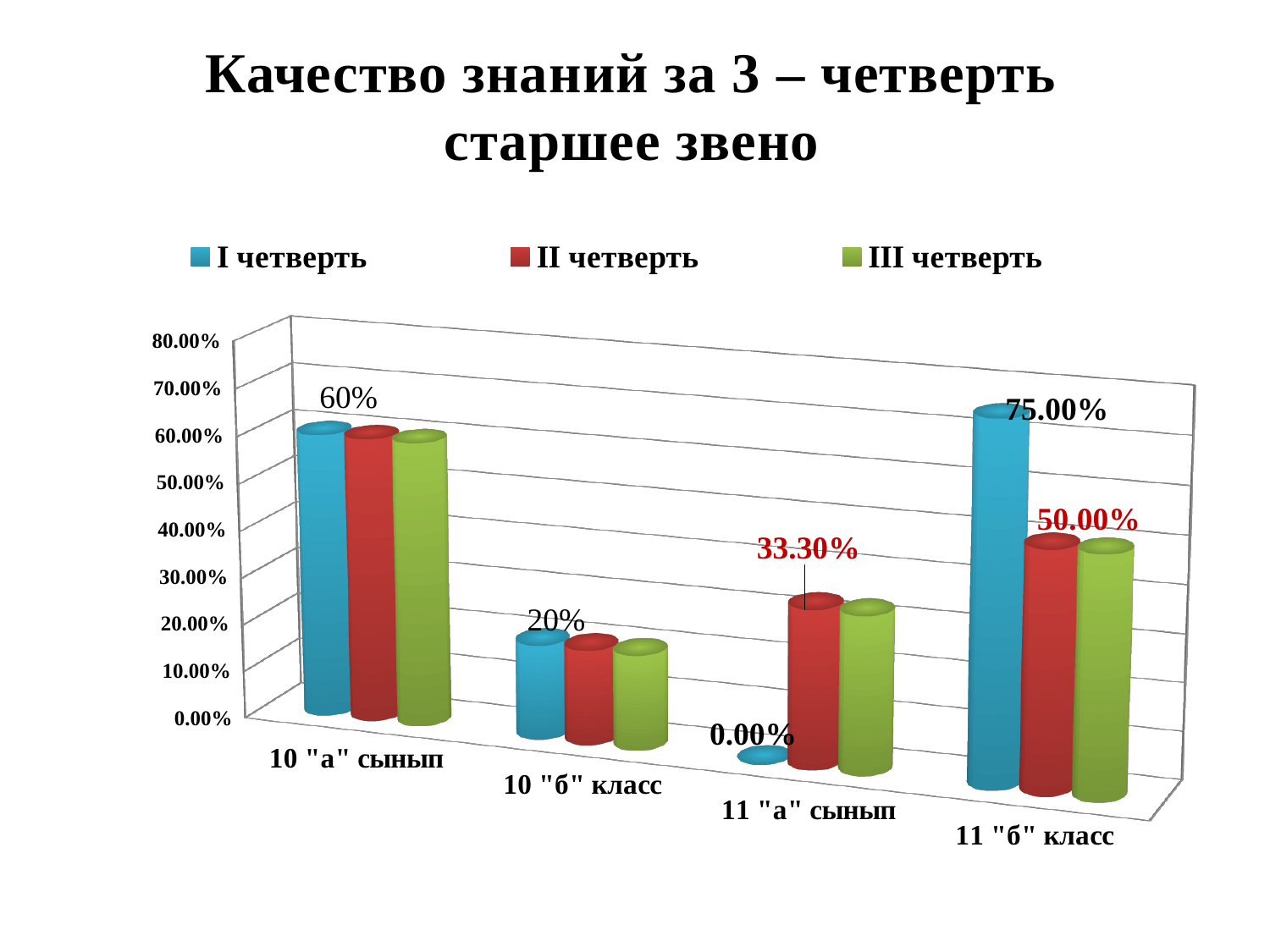
What is the value for I четверть for 10 "б" класс? 20% What is the value for I четверть for 11 "б" класс? 75.00% Which class has the highest I четверть value? 11 "б" класс What is the value for II четверть for 11 "б" класс? 50.00% How many class categories are shown on the x axis? 4 What is the value for I четверть for 11 "а" сынып? 0.00% What is the difference between the I четверть and II четверть values for 11 "б" класс? 25.00% What type of chart is shown on the slide? bar chart What is the value for I четверть for 10 "а" сынып? 60% Is the III четверть value for 10 "б" класс greater or less than 30.00%? less How many series does the legend list? 3 What is the value for II четверть for 11 "а" сынып? 33.30%